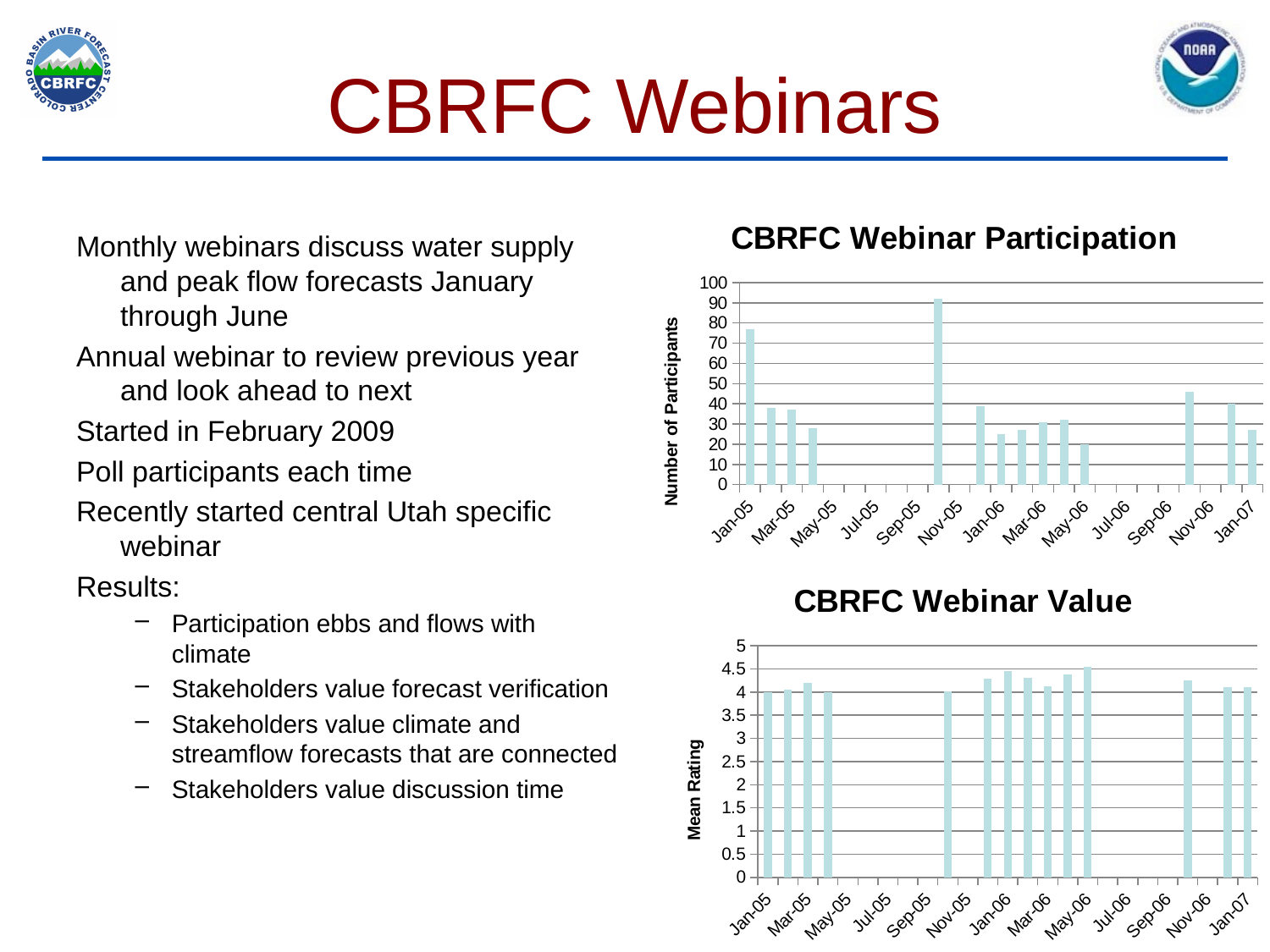
In the CBRFC Webinar Value chart, is the value for Jan-07 greater or less than 4.5? less How many month labels are shown on the x axis of the CBRFC Webinar Participation chart? 13 In the CBRFC Webinar Participation chart, is the value for Jan-05 greater or less than the value for Mar-05? greater What kind of chart is the CBRFC Webinar Participation chart? bar chart In the CBRFC Webinar Value chart, is the value for Jan-05 greater or less than 3.5? greater What is the y-axis title of the CBRFC Webinar Value chart? Mean Rating What kind of chart is the CBRFC Webinar Value chart? bar chart In the CBRFC Webinar Participation chart, is the value for Jan-05 greater or less than 70? greater What is the y-axis title of the CBRFC Webinar Participation chart? Number of Participants